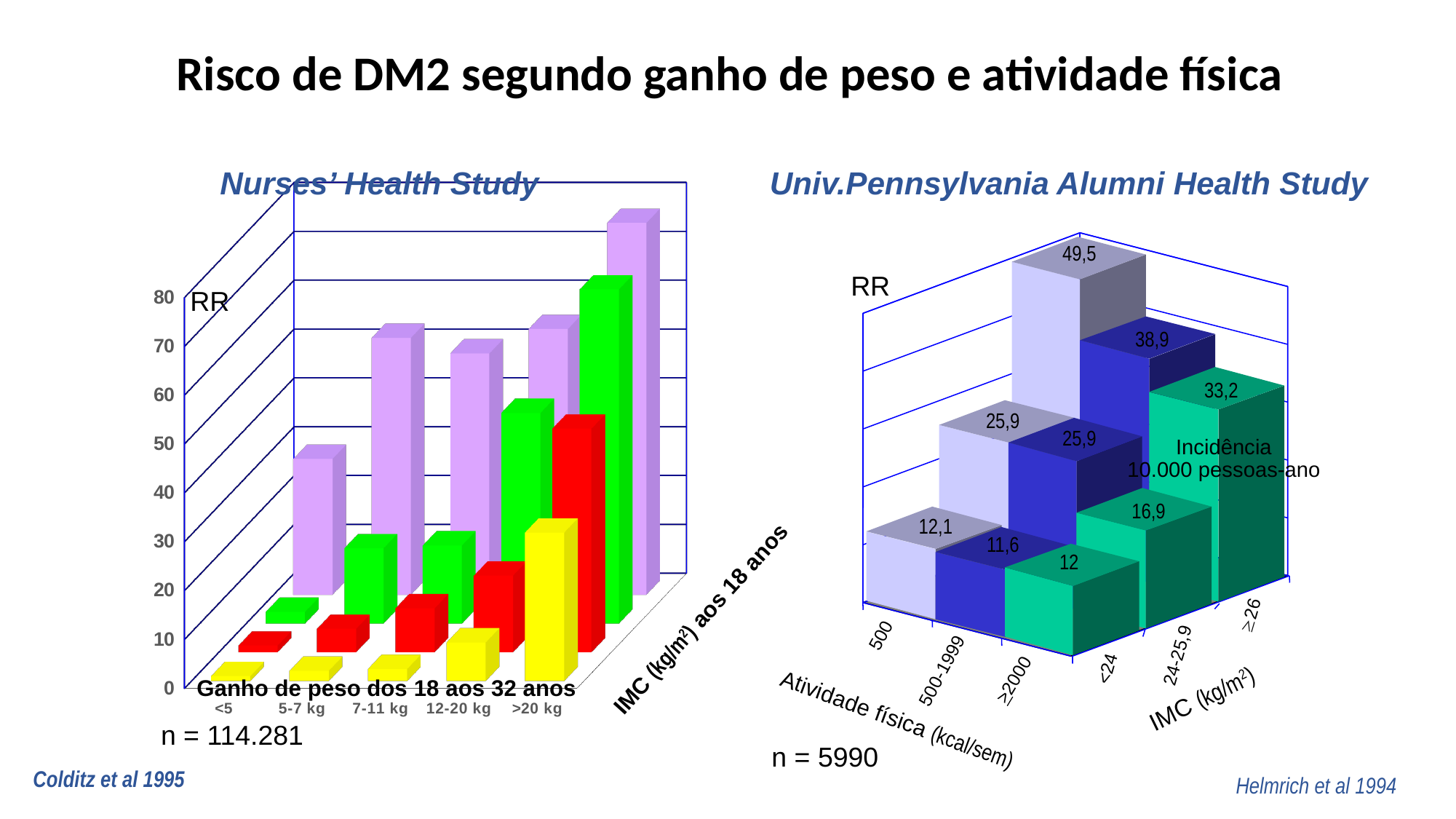
On the left chart (Nurses' Health Study), how many differently coloured series of bars are plotted? 4 On the right chart (Univ.Pennsylvania Alumni Health Study), how many bars are plotted in total? 9 On the right chart (Univ.Pennsylvania Alumni Health Study), what is the lowest labeled value? 11,6 On the right chart (Univ.Pennsylvania Alumni Health Study), what is the difference between the highest labeled value and the lowest labeled value? 37,9 What type of chart is the Univ.Pennsylvania Alumni Health Study chart on the right? bar chart What is the highest value on the RR axis of the left chart (Nurses' Health Study)? 80 On the left chart (Nurses' Health Study), which weight-gain category has the tallest bar? >20 kg On the left chart (Nurses' Health Study), how many weight-gain categories are shown on the x axis? 5 On the left chart (Nurses' Health Study), do the yellow bars rise or fall from <5 to >20 kg? rise On the right chart (Univ.Pennsylvania Alumni Health Study), what is the highest labeled value? 49,5 On the left chart (Nurses' Health Study), is the yellow bar for >20 kg greater or less than 10? greater What type of chart is the Nurses' Health Study chart on the left? bar chart